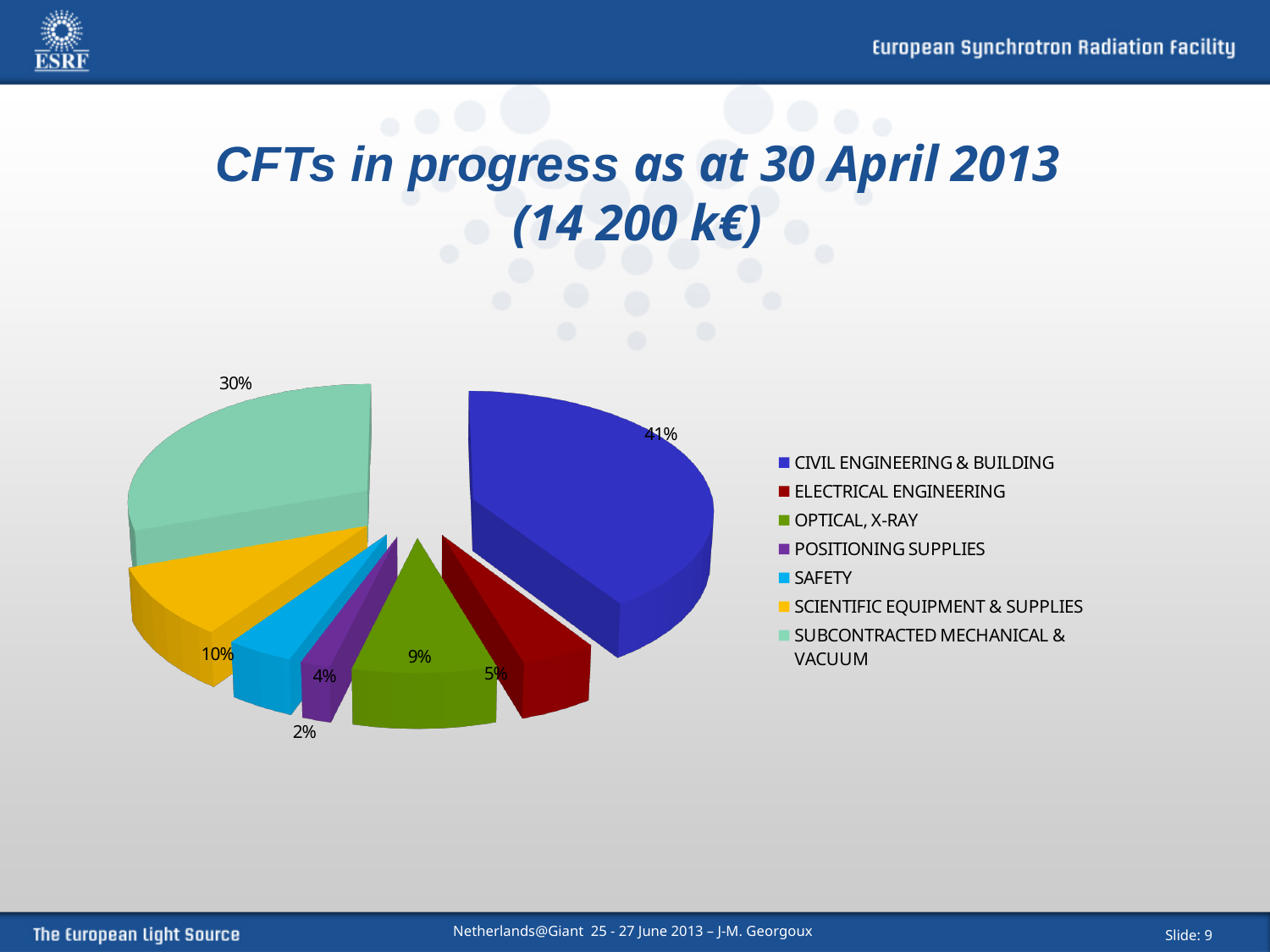
Which category has the largest slice of the pie? CIVIL ENGINEERING & BUILDING What kind of chart is shown on the slide? pie chart What share of the pie does SUBCONTRACTED MECHANICAL & VACUUM represent? 30% Which is larger, the slice for ELECTRICAL ENGINEERING or the slice for SAFETY? ELECTRICAL ENGINEERING Which category has the smallest slice of the pie? POSITIONING SUPPLIES What is the value shown for POSITIONING SUPPLIES? 2% What is the value shown for OPTICAL, X-RAY? 9% What is the title of the slide containing the chart? CFTs in progress as at 30 April 2013 (14 200 k€) How many categories does the pie chart have? 7 What is the difference in percentage points between CIVIL ENGINEERING & BUILDING and SUBCONTRACTED MECHANICAL & VACUUM? 11 What is the value shown for SCIENTIFIC EQUIPMENT & SUPPLIES? 10% What share of the pie does CIVIL ENGINEERING & BUILDING represent? 41%